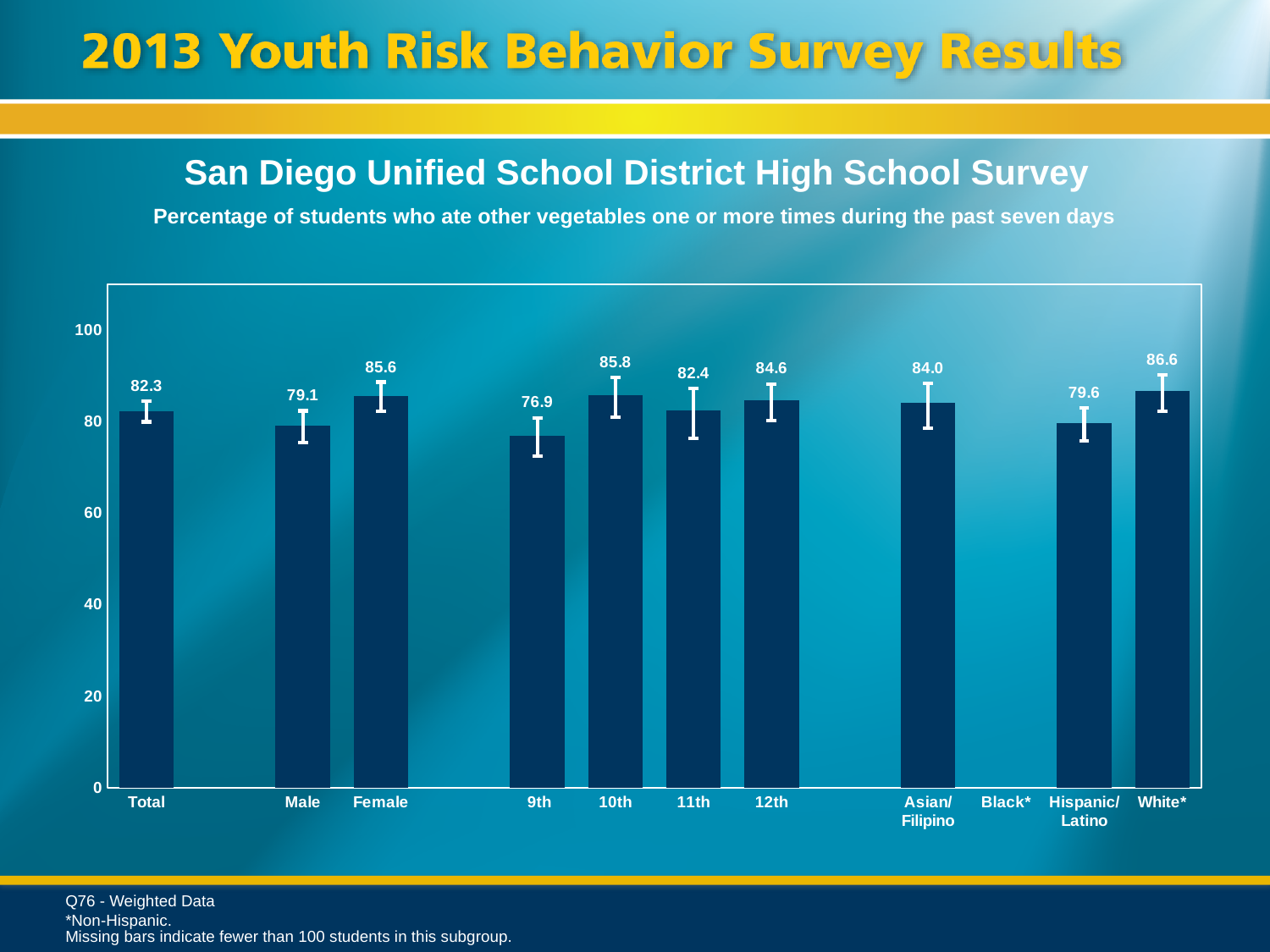
What is the difference between the 10th grade and 9th grade values? 8.9 Which category has the highest value? White* Which category on the x axis has no bar plotted? Black* Is the value for Hispanic/Latino greater or less than 80? less What does the chart subtitle say the percentages measure? Percentage of students who ate other vegetables one or more times during the past seven days What is the value for Total? 82.3 Which is larger, the value for 12th grade or 11th grade? 12th Which category has the lowest value? 9th What is the value for 9th grade students? 76.9 What is the difference between the Female and Male values? 6.5 What kind of chart is shown? bar chart What is the value for Asian/Filipino students? 84.0